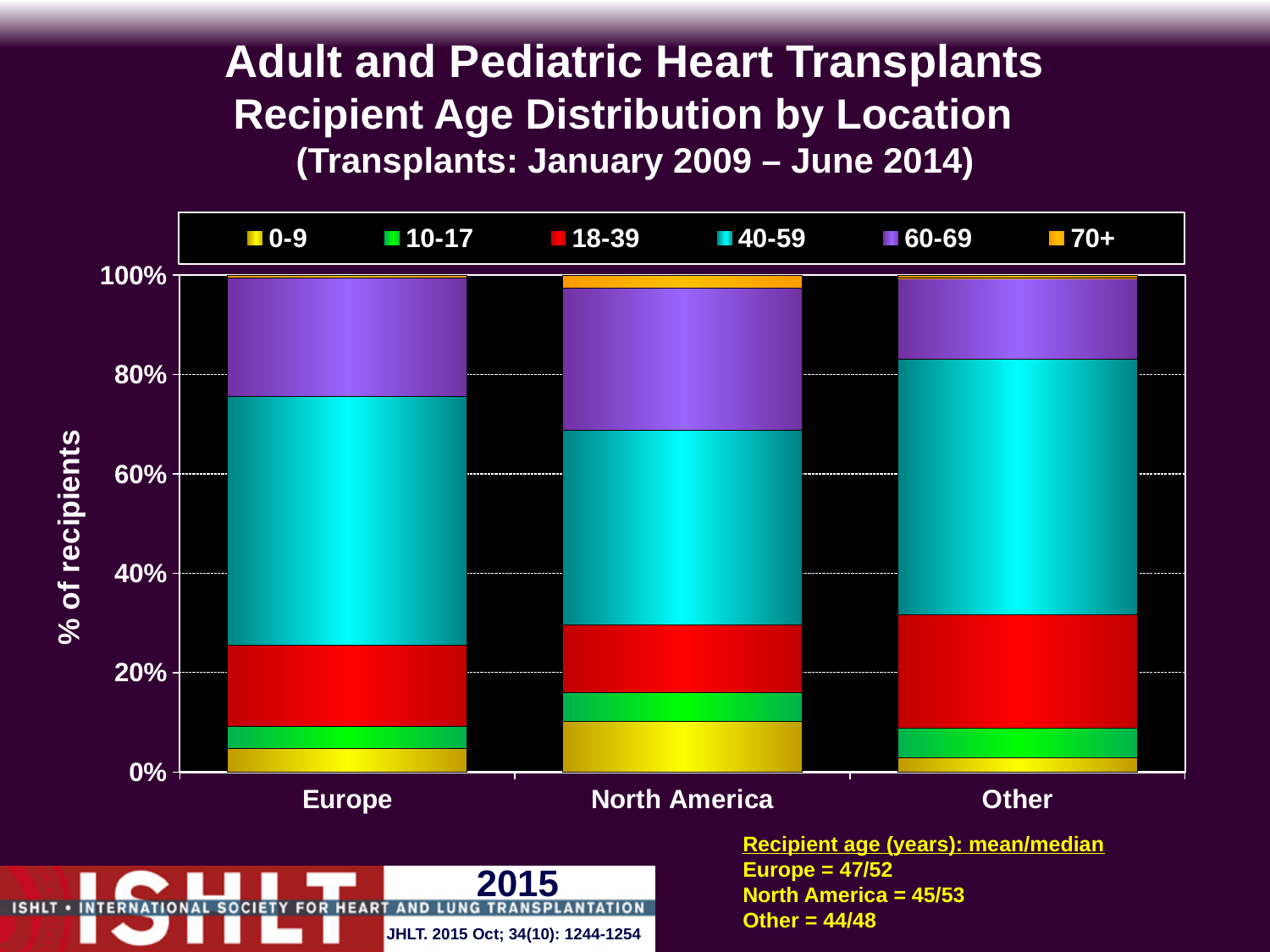
Which location has the smallest share of recipients aged 60-69? Other Is the value for the 0-9 age group in North America greater or less than 20%? less What transplant period does the chart title state? January 2009 – June 2014 What kind of chart is shown on the slide? Stacked bar chart Which location has the largest share of recipients aged 70+? North America Is the value for the 18-39 age group in Europe greater or less than 20%? less How many locations (categories) are shown on the x axis? 3 Which location has the largest share of recipients aged 0-9? North America What is the label of the y axis? % of recipients How many age groups does the legend list? 6 Is the value for the 60-69 age group in North America greater or less than 20%? greater